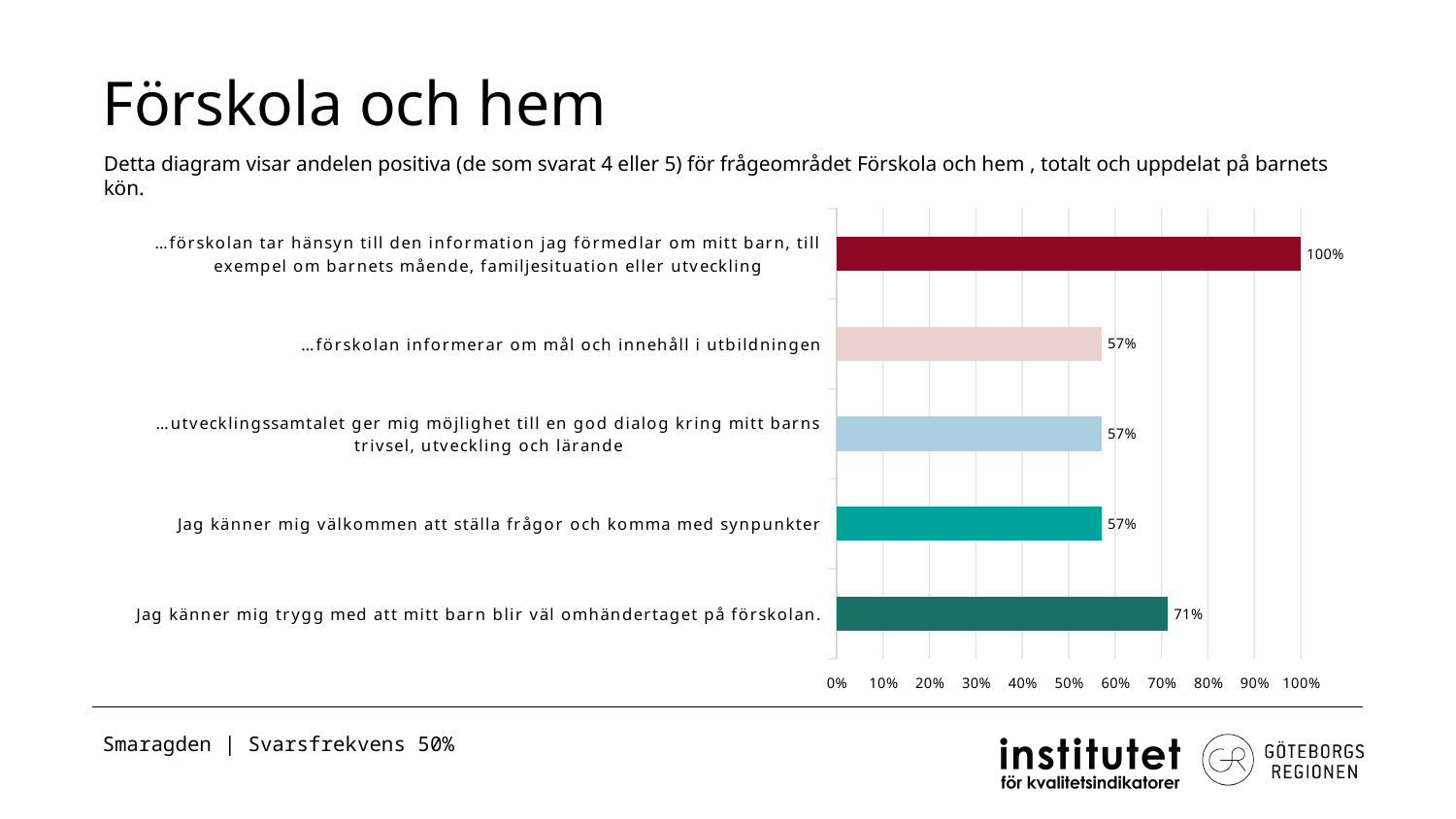
Is the value for "Jag känner mig trygg med att mitt barn blir väl omhändertaget på förskolan." greater or less than 60%? greater What is the difference between the value for "…förskolan tar hänsyn till den information jag förmedlar om mitt barn, till exempel om barnets mående, familjesituation eller utveckling" and the value for "Jag känner mig trygg med att mitt barn blir väl omhändertaget på förskolan."? 29% What kind of chart is shown on the slide? bar chart How many categories are shown in the chart? 5 What is the value for "…förskolan tar hänsyn till den information jag förmedlar om mitt barn, till exempel om barnets mående, familjesituation eller utveckling"? 100% What is the value for "Jag känner mig välkommen att ställa frågor och komma med synpunkter"? 57% What is the value for "…förskolan informerar om mål och innehåll i utbildningen"? 57% What is the title of the slide containing the chart? Förskola och hem Which is larger: the value for "Jag känner mig trygg med att mitt barn blir väl omhändertaget på förskolan." or the value for "…utvecklingssamtalet ger mig möjlighet till en god dialog kring mitt barns trivsel, utveckling och lärande"? Jag känner mig trygg med att mitt barn blir väl omhändertaget på förskolan. What is the value for "Jag känner mig trygg med att mitt barn blir väl omhändertaget på förskolan."? 71% What is the difference between the value for "Jag känner mig trygg med att mitt barn blir väl omhändertaget på förskolan." and the value for "Jag känner mig välkommen att ställa frågor och komma med synpunkter"? 14% Which category has the highest value? …förskolan tar hänsyn till den information jag förmedlar om mitt barn, till exempel om barnets mående, familjesituation eller utveckling